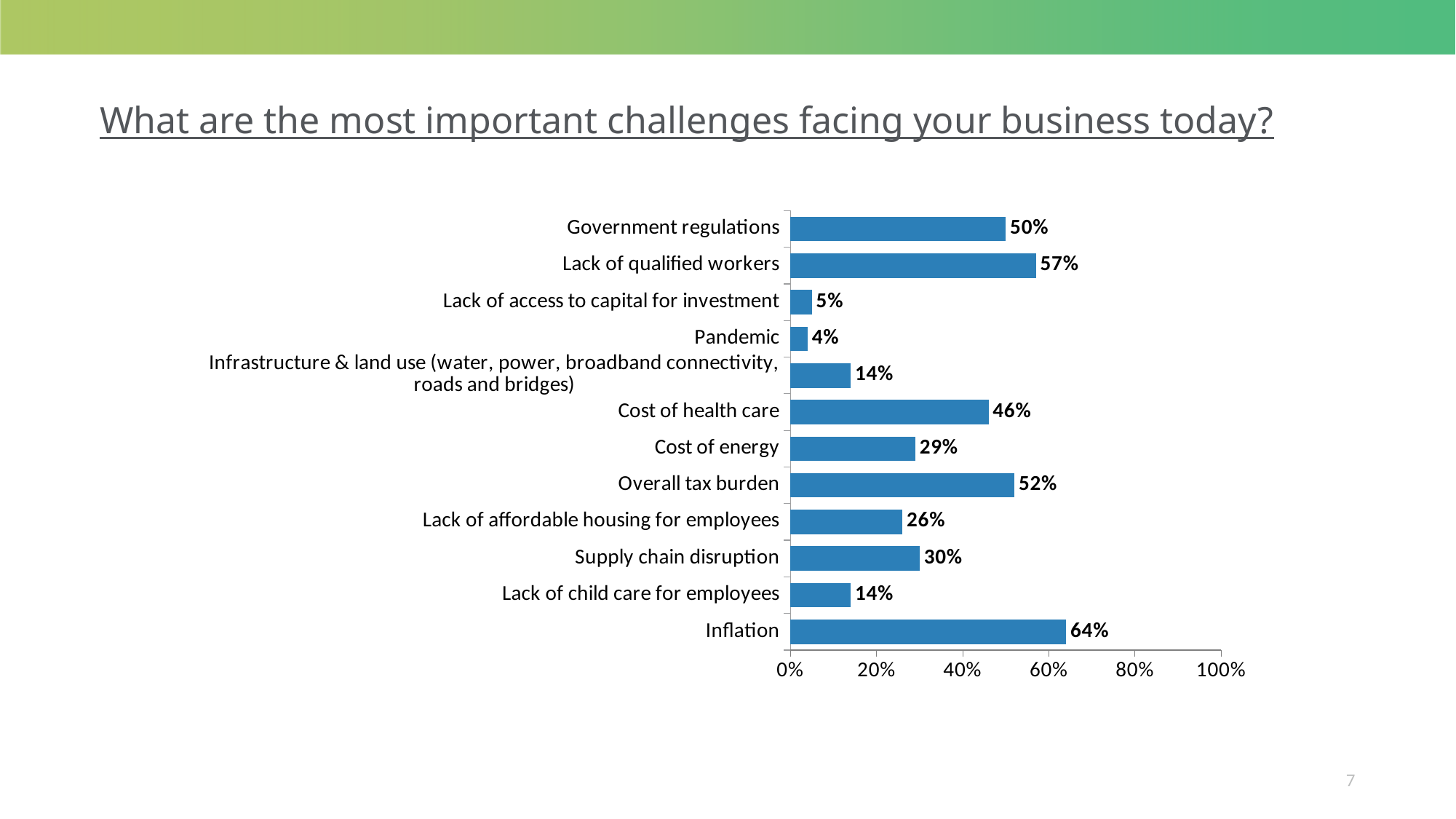
What is the difference between Overall tax burden and Cost of health care? 6% What percentage of respondents cited Inflation as a challenge? 64% Which is larger, Supply chain disruption or Lack of affordable housing for employees? Supply chain disruption What is the difference between the values for Inflation and Government regulations? 14% What is the value for Cost of energy? 29% Is the value for Cost of health care greater or less than 40%? greater How many challenge categories are shown in the chart? 12 What is the value for Lack of qualified workers? 57% Which challenge has the highest percentage? Inflation Which challenge has the lowest percentage? Pandemic What is the title of the slide? What are the most important challenges facing your business today? What kind of chart is shown on the slide? Bar chart